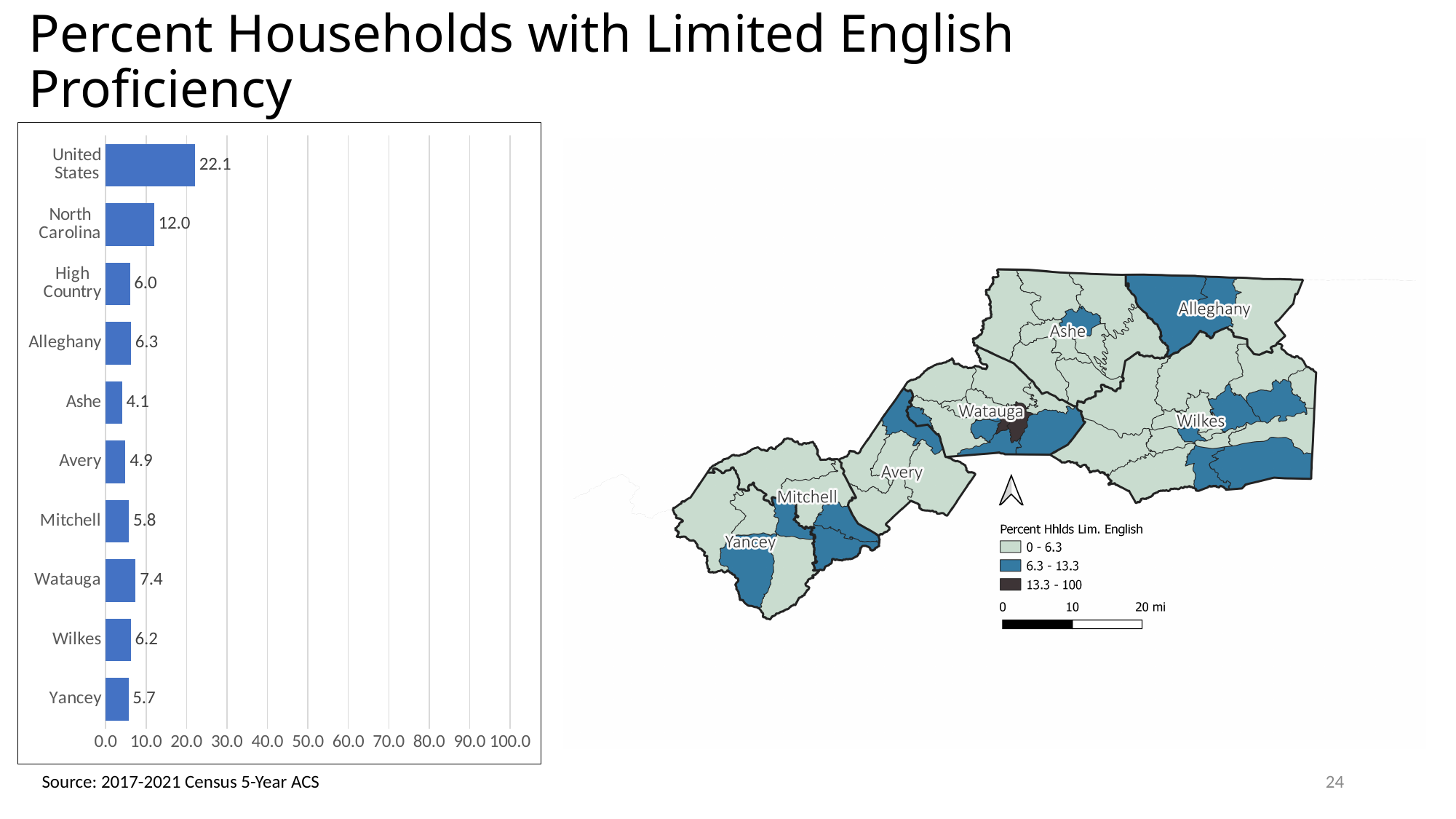
What is the highest tick value shown on the x axis of the bar chart? 100.0 What is the value for North Carolina in the bar chart? 12.0 What is the value for Watauga in the bar chart? 7.4 What is the difference between the United States value and the North Carolina value in the bar chart? 10.1 Which category has the highest value in the bar chart? United States How many classes does the map legend 'Percent Hhlds Lim. English' list? 3 What is the value for Ashe in the bar chart? 4.1 In the bar chart, which is larger: the value for Watauga or the value for Wilkes? Watauga Is the value for United States in the bar chart greater or less than 20.0? greater What kind of chart is shown on the left of the slide? Bar chart Which category has the lowest value in the bar chart? Ashe How many categories are shown in the bar chart? 10